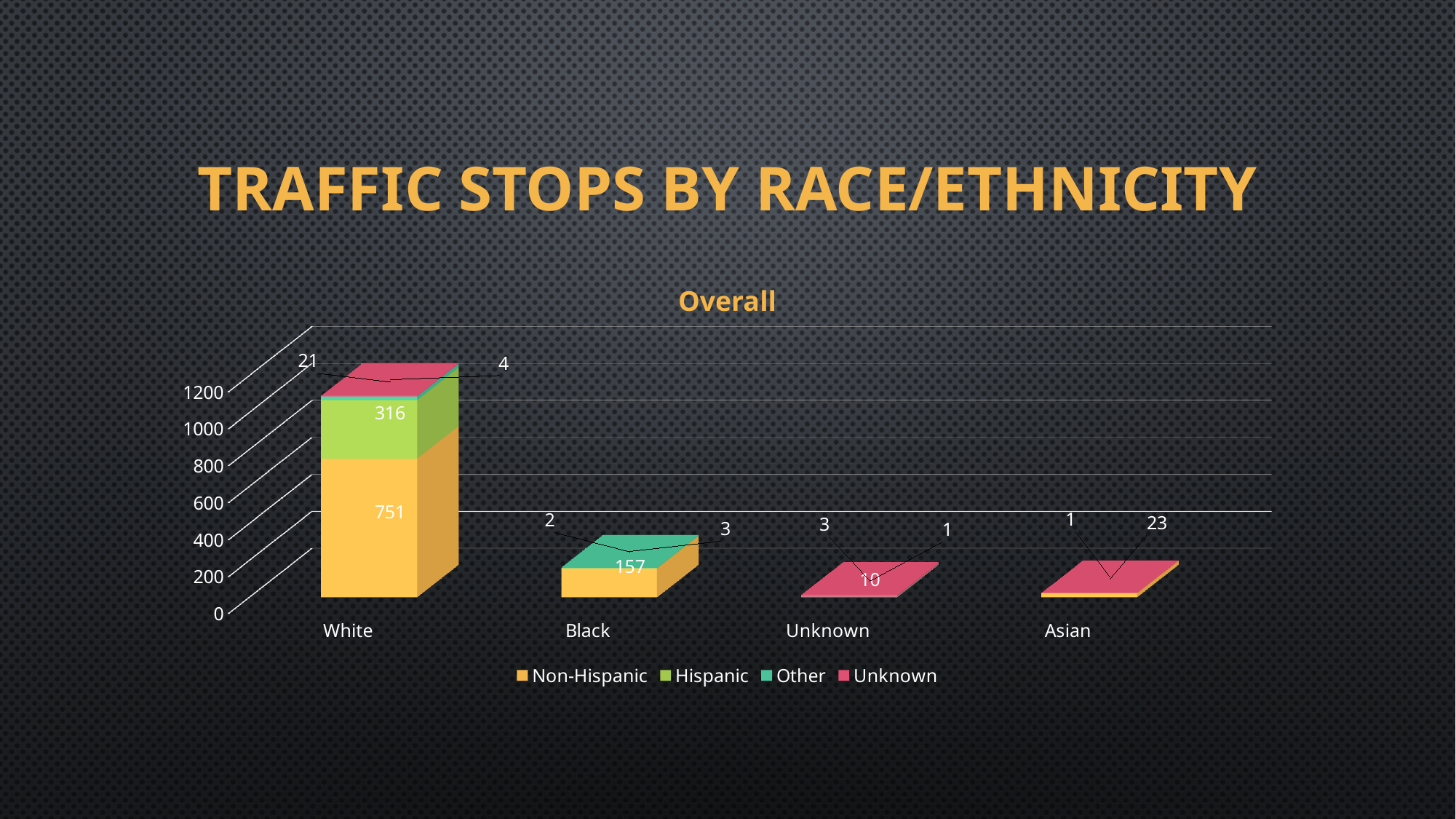
Is the total of the White bar greater or less than 1000? greater Which is larger, the Non-Hispanic value for White or the Non-Hispanic value for Black? White What is the Unknown series value for the Asian category? 1 What is the Hispanic value for White? 316 What is the Non-Hispanic value for Black? 157 What is the Non-Hispanic value for White? 751 How many series does the legend list? 4 What kind of chart is shown? stacked bar chart What is the difference between the Non-Hispanic and Hispanic values for White? 435 Which category has the tallest stacked bar? White What is the title of the chart? Overall How many categories are shown on the x axis? 4